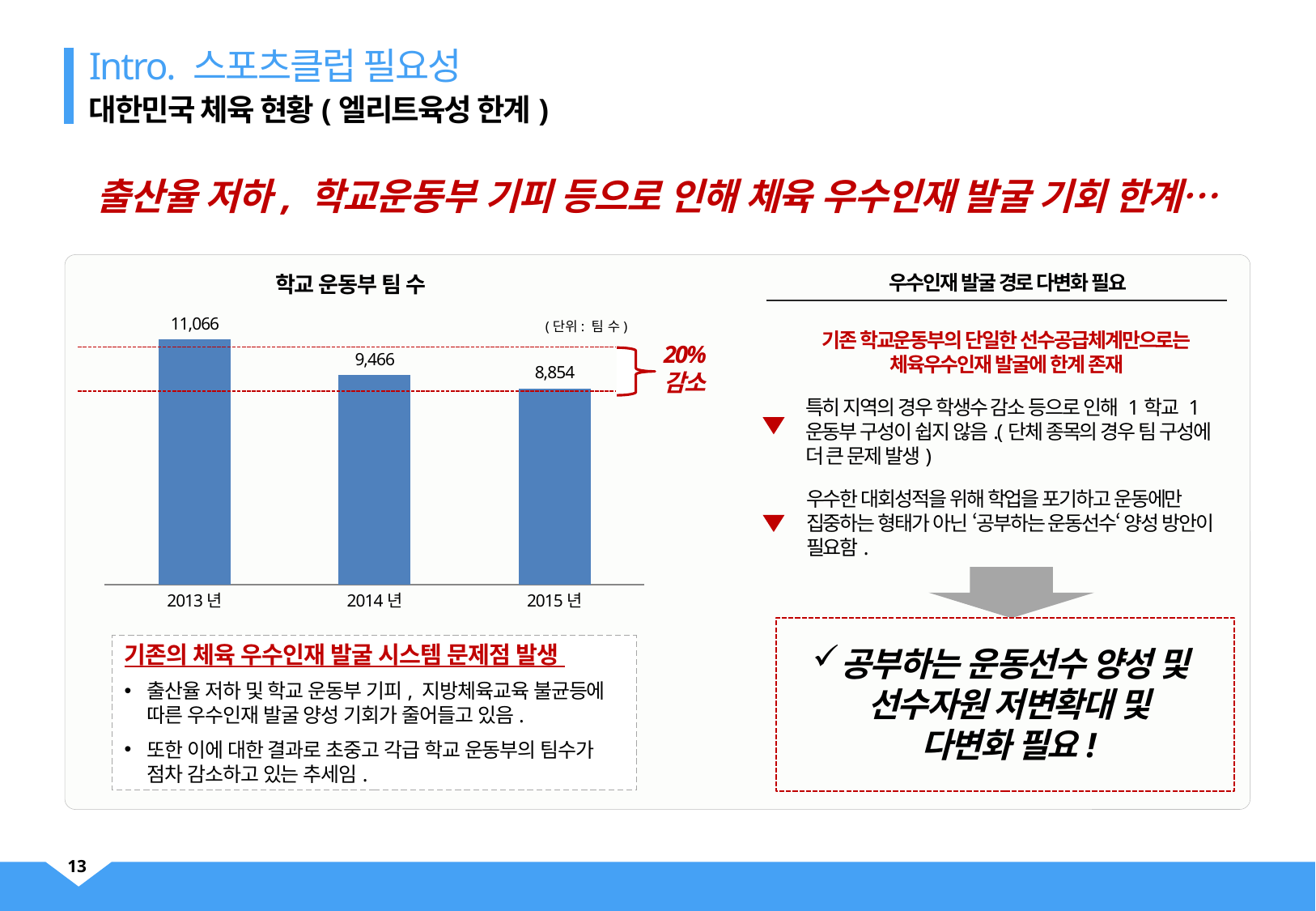
Do the values rise or fall from 2013년 to 2015년? Fall What kind of chart is shown on the slide? Bar chart Which is larger, the value for 2014년 or the value for 2015년? 2014년 What is the title of the chart? 학교 운동부 팀 수 What is the value for 2014년 in the chart? 9,466 What is the difference between the values for 2013년 and 2015년? 2,212 What is the difference between the values for 2014년 and 2015년? 612 Which year has the lowest value in the chart? 2015년 What is the value for 2015년 in the chart? 8,854 Which year has the highest value in the chart? 2013년 What is the value for 2013년 in the chart? 11,066 How many years are shown in the chart? 3